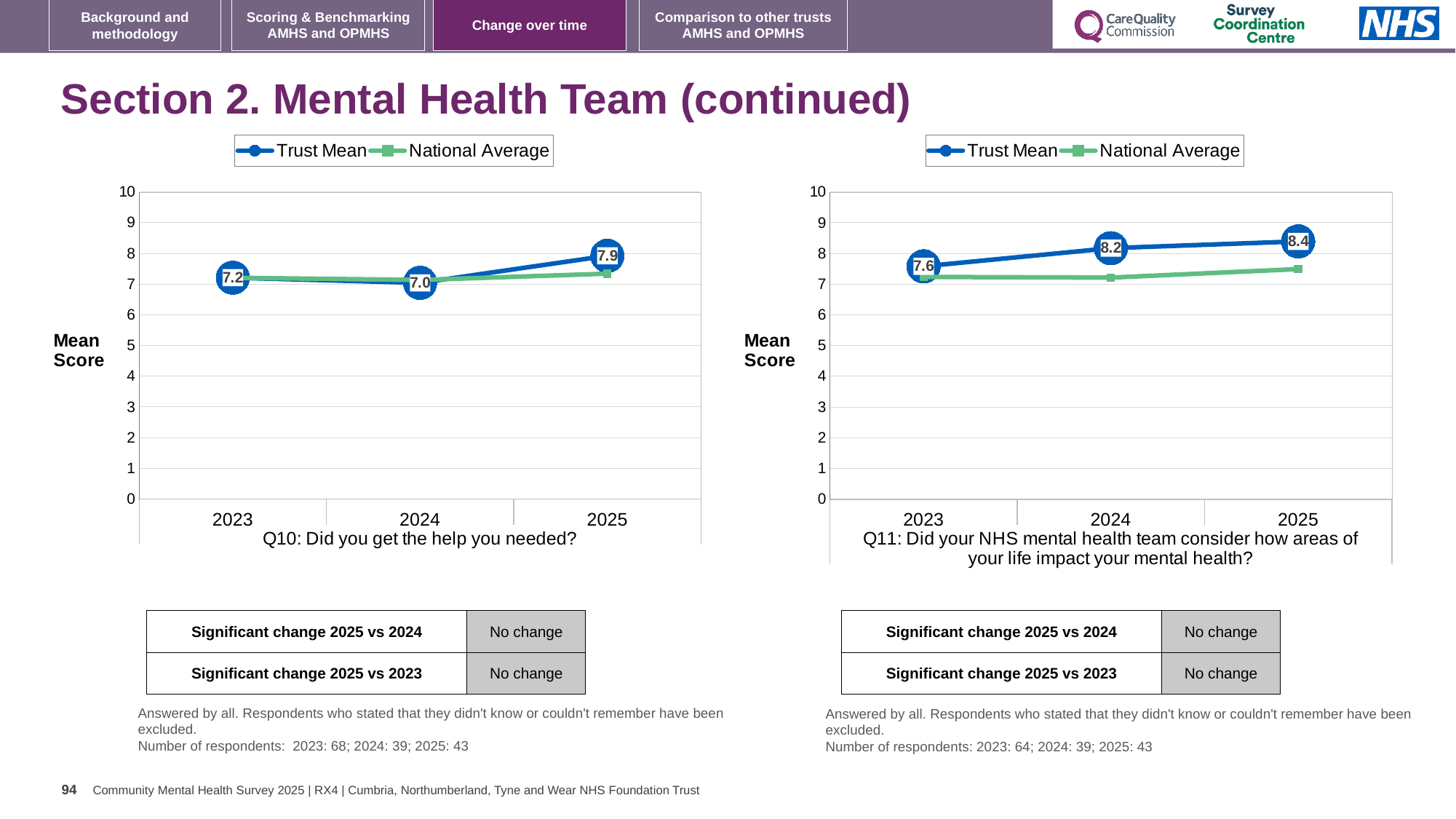
On the Q10 chart, what is the Trust Mean for 2025? 7.9 On the Q11 chart, which year has the highest Trust Mean? 2025 On the Q11 chart, is the National Average for 2024 greater or less than 8? less On the Q10 chart, what is the Trust Mean for 2024? 7.0 How many series does the legend of the Q10 chart list? 2 On the Q10 chart, what is the difference between the Trust Mean for 2025 and 2024? 0.9 On the Q11 chart, does the Trust Mean rise or fall from 2023 to 2025? rise On the Q10 chart, which year has the lowest Trust Mean? 2024 On the Q11 chart, what is the Trust Mean for 2025? 8.4 On the Q11 chart, what is the Trust Mean for 2023? 7.6 On the Q11 chart, is the Trust Mean or the National Average higher in 2024? Trust Mean On the Q11 chart, what is the difference between the Trust Mean for 2025 and 2023? 0.8